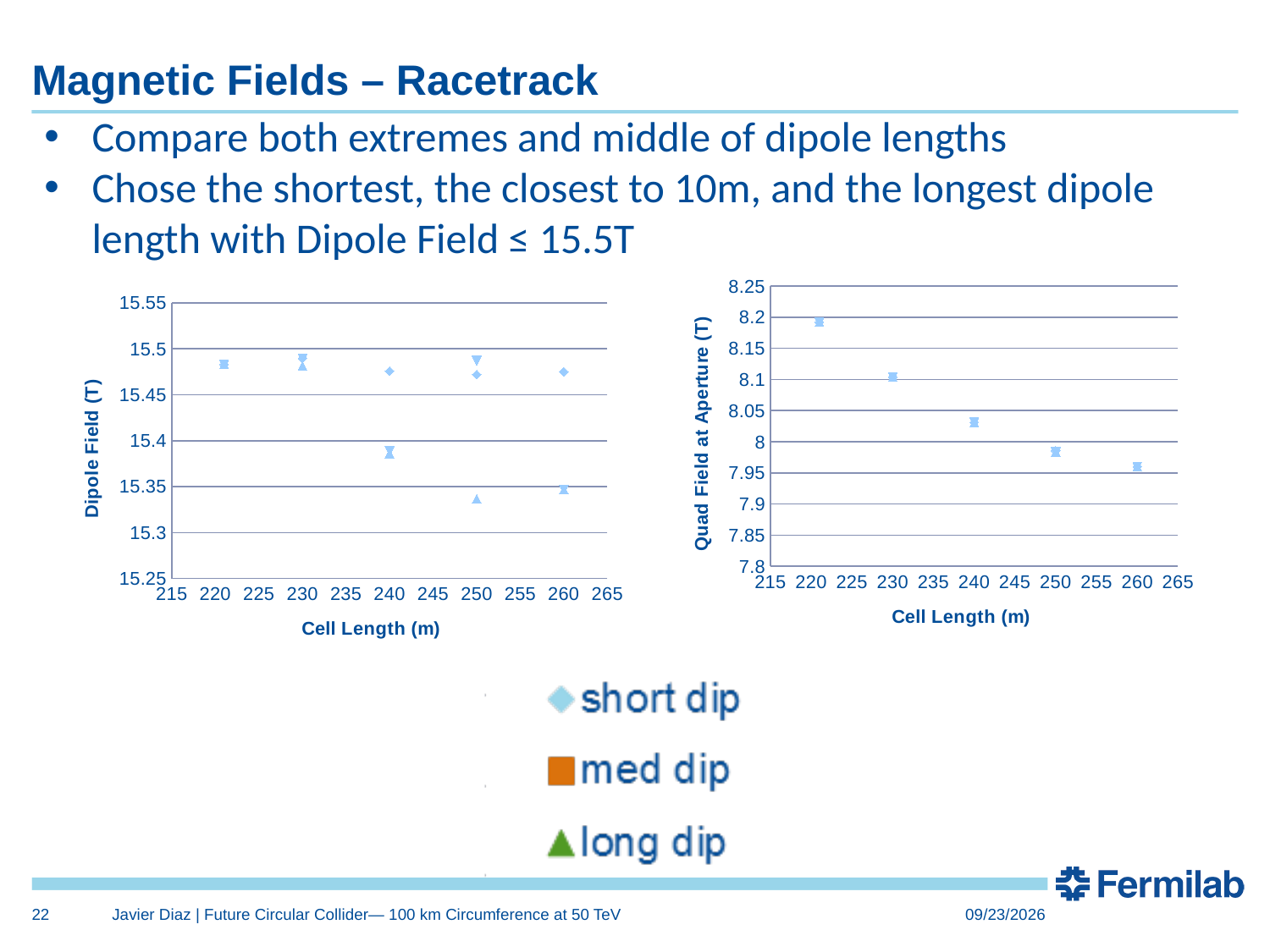
In the right chart, Quad Field at Aperture (T), is the value at cell length 220 m greater or less than 8.15? greater In the left chart, Dipole Field (T), is the long dip value at cell length 250 m greater or less than 15.4? less What is the y-axis title of the right chart? Quad Field at Aperture (T) How many series does the legend below the charts list? 3 In the right chart, Quad Field at Aperture (T), is the value at cell length 240 m greater or less than 8? greater In the right chart, Quad Field at Aperture (T), do the values rise or fall as cell length increases? fall In the left chart, Dipole Field (T), which cell length has the highest quad field in the right chart: 220 m or 260 m? 220 m In the right chart, Quad Field at Aperture (T), how many data points are plotted? 5 What is the x-axis title shared by both charts? Cell Length (m) What kind of chart is the left chart, Dipole Field (T) versus Cell Length (m)? scatter chart